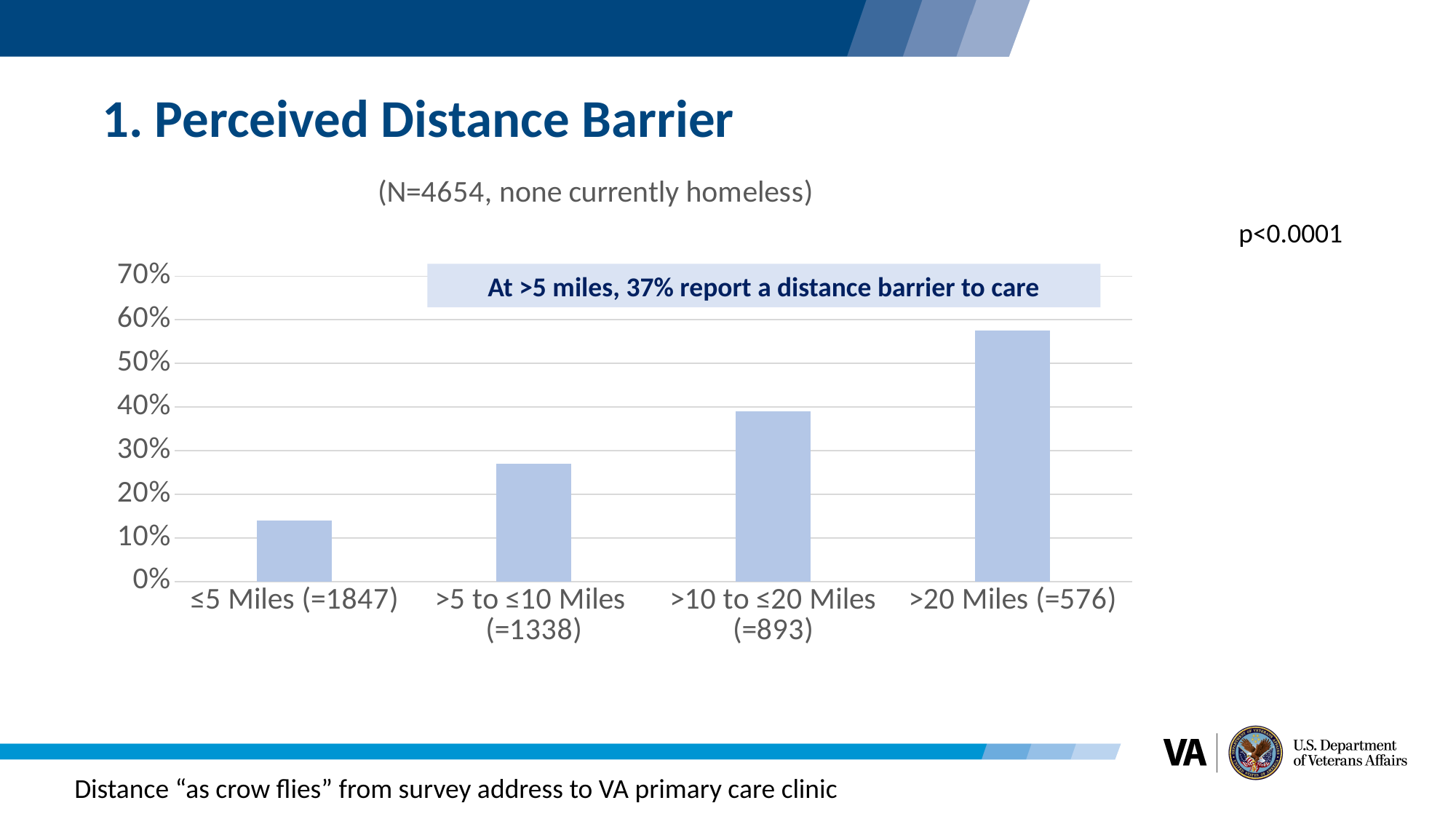
Is the value for ≤5 Miles (=1847) greater or less than 20%? less What kind of chart is shown on the slide? bar chart How many distance categories are plotted on the chart? 4 Is the value for >10 to ≤20 Miles (=893) greater or less than 30%? greater Which is larger, the value for >10 to ≤20 Miles (=893) or the value for >5 to ≤10 Miles (=1338)? >10 to ≤20 Miles (=893) Which distance category has the lowest bar? ≤5 Miles (=1847) Which distance category has the highest bar? >20 Miles (=576) What sample size is stated in the chart's subtitle? N=4654 Is the value for >5 to ≤10 Miles (=1338) greater or less than 30%? less Do the values rise or fall as distance increases along the x axis? rise